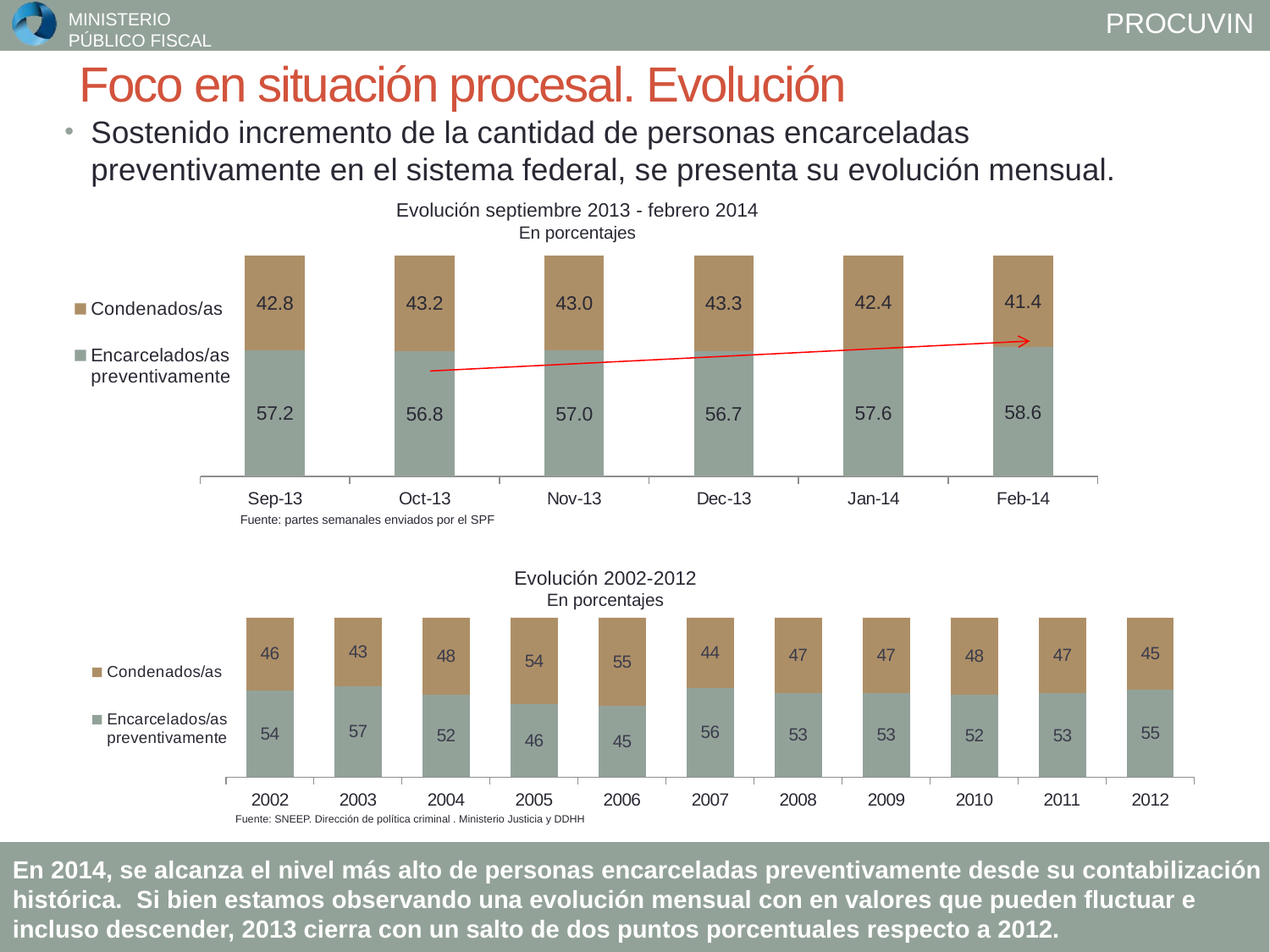
In the chart titled 'Evolución 2002-2012', which year has the highest value for Encarcelados/as preventivamente? 2003 In the chart titled 'Evolución septiembre 2013 - febrero 2014', how many months are shown on the x axis? 6 In the chart titled 'Evolución septiembre 2013 - febrero 2014', which month has the highest value for Encarcelados/as preventivamente? Feb-14 What kind of chart is the chart titled 'Evolución 2002-2012'? Stacked bar chart In the chart titled 'Evolución septiembre 2013 - febrero 2014', what is the value for Encarcelados/as preventivamente in Feb-14? 58.6 In the chart titled 'Evolución septiembre 2013 - febrero 2014', what is the difference between the Encarcelados/as preventivamente values for Feb-14 and Sep-13? 1.4 In the chart titled 'Evolución 2002-2012', how many series does the legend list? 2 In the chart titled 'Evolución 2002-2012', what is the value for Encarcelados/as preventivamente in 2006? 45 In the chart titled 'Evolución 2002-2012', which is larger in 2007: Condenados/as or Encarcelados/as preventivamente? Encarcelados/as preventivamente In the chart titled 'Evolución septiembre 2013 - febrero 2014', what is the value for Condenados/as in Dec-13? 43.3 In the chart titled 'Evolución 2002-2012', what is the value for Condenados/as in 2005? 54 In the chart titled 'Evolución septiembre 2013 - febrero 2014', which month has the lowest value for Condenados/as? Feb-14